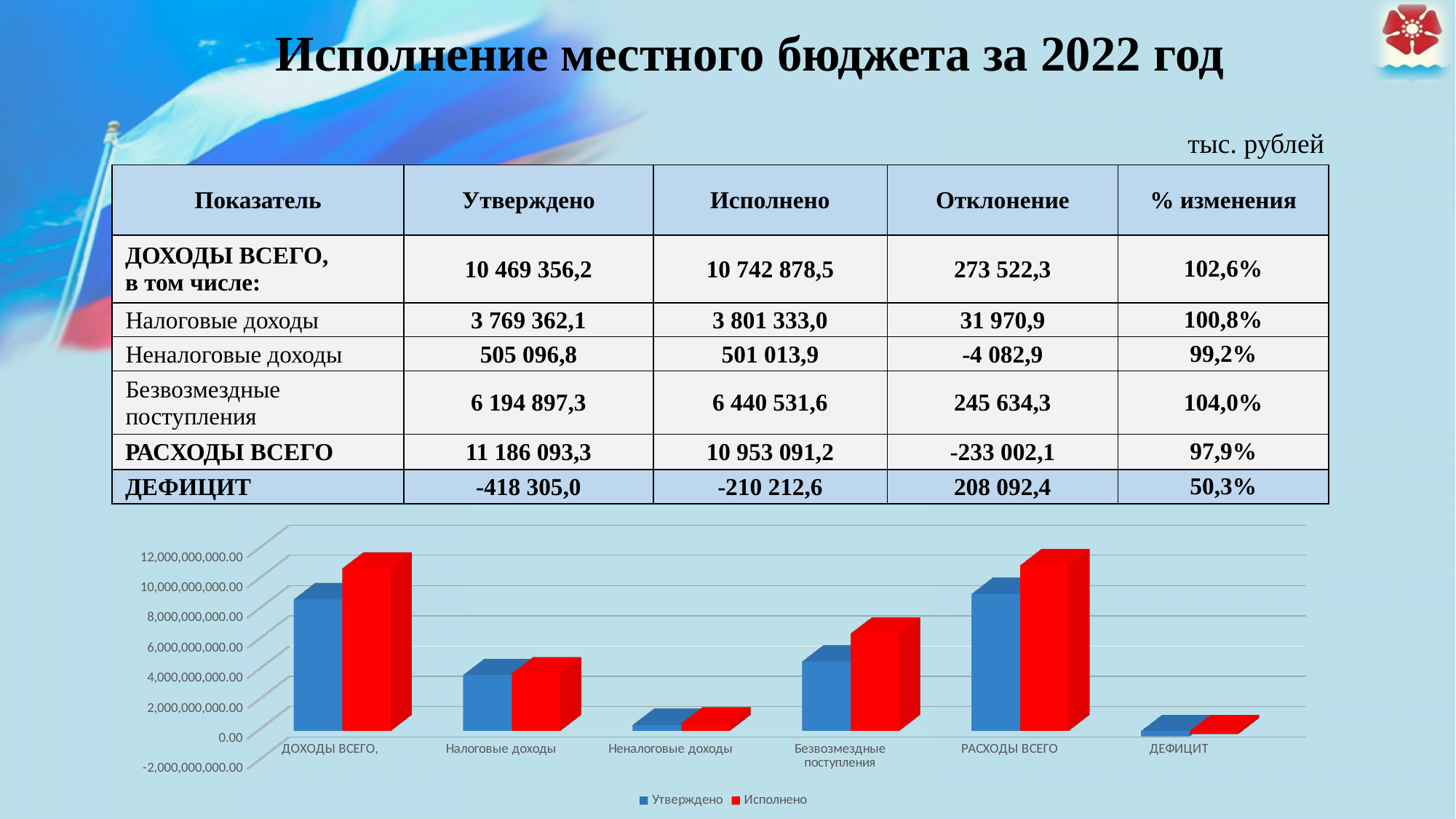
In the chart, is the Утверждено value for Налоговые доходы greater or less than 6,000,000,000.00? less Which category has the lowest bars in the chart? ДЕФИЦИТ How many categories are shown on the x axis of the chart? 6 In the chart, is the Исполнено value for Безвозмездные поступления greater or less than 4,000,000,000.00? greater What kind of chart is shown at the bottom of the slide? bar chart In the chart, which is larger for the Утверждено series: Неналоговые доходы or Налоговые доходы? Налоговые доходы In the chart, is the Исполнено value for Неналоговые доходы greater or less than 2,000,000,000.00? less In the chart, which is larger for the Исполнено series: Налоговые доходы or Безвозмездные поступления? Безвозмездные поступления How many series does the chart legend list? 2 Which colour represents the Исполнено series in the chart? red What are the two series named in the chart legend? Утверждено and Исполнено